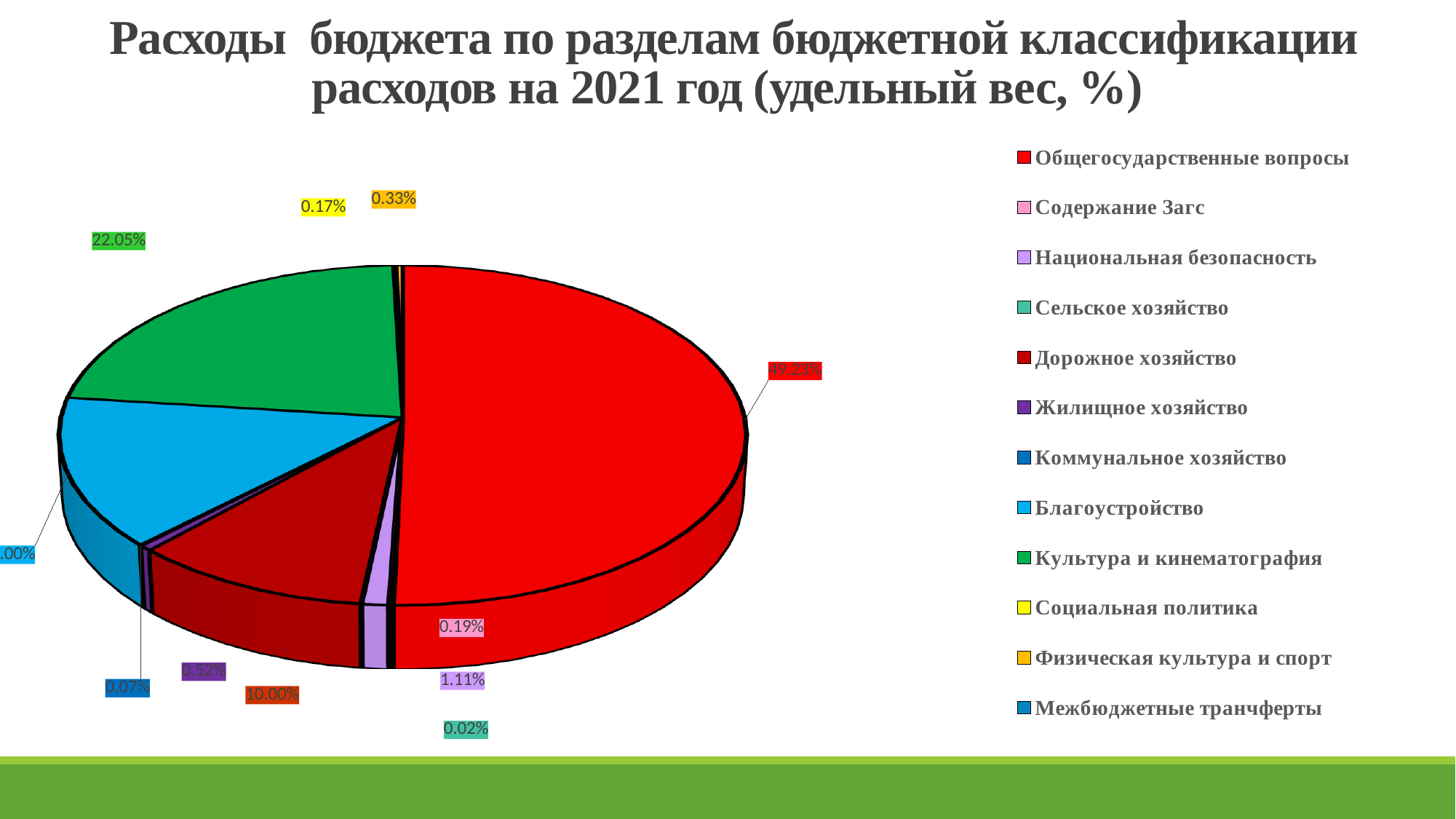
How many sections are listed in the legend? 12 What share of budget expenditure is shown for Общегосударственные вопросы? 49.23% What is the difference in percentage points between Общегосударственные вопросы and Культура и кинематография? 27.18 What share is shown for Культура и кинематография? 22.05% What share is shown for Физическая культура и спорт? 0.33% What type of chart is shown on the slide? Pie chart Which section has the largest share of budget expenditure? Общегосударственные вопросы What share is shown for Национальная безопасность? 1.11% What share is shown for Дорожное хозяйство? 10.00% What share is shown for Сельское хозяйство? 0.02% Which has a larger share: Дорожное хозяйство or Жилищное хозяйство? Дорожное хозяйство